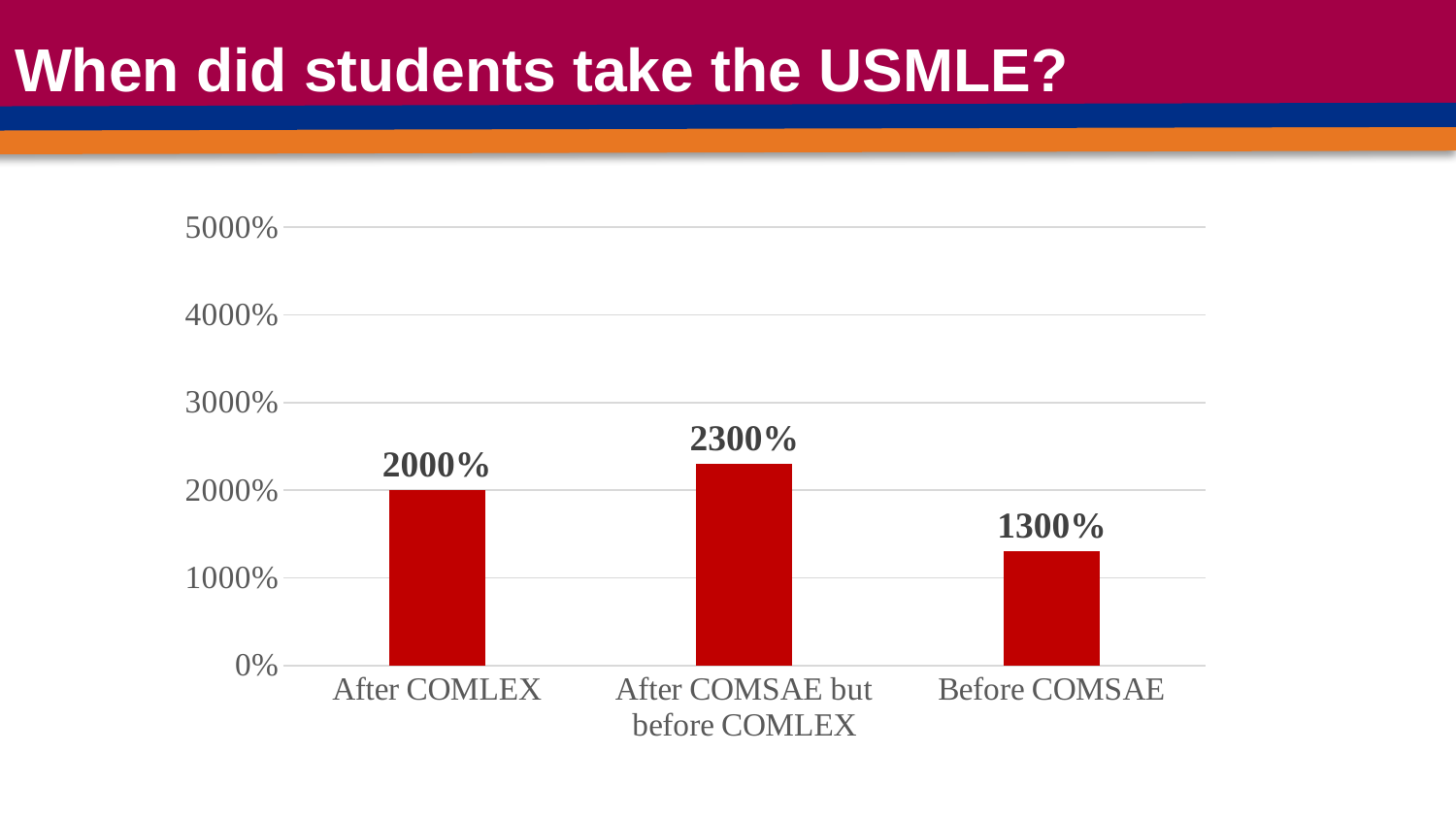
What kind of chart is shown on the slide? bar chart What is the difference between the values for After COMLEX and Before COMSAE? 700% What is the value for After COMLEX? 2000% Which category has the highest value? After COMSAE but before COMLEX Which category has the lowest value? Before COMSAE What is the value for After COMSAE but before COMLEX? 2300% What is the difference between the values for After COMSAE but before COMLEX and After COMLEX? 300% How many categories are shown on the chart? 3 What is the title of the slide containing the chart? When did students take the USMLE? Is the value for Before COMSAE greater or less than 2000%? less What is the value for Before COMSAE? 1300% Which is larger, the value for After COMLEX or the value for Before COMSAE? After COMLEX